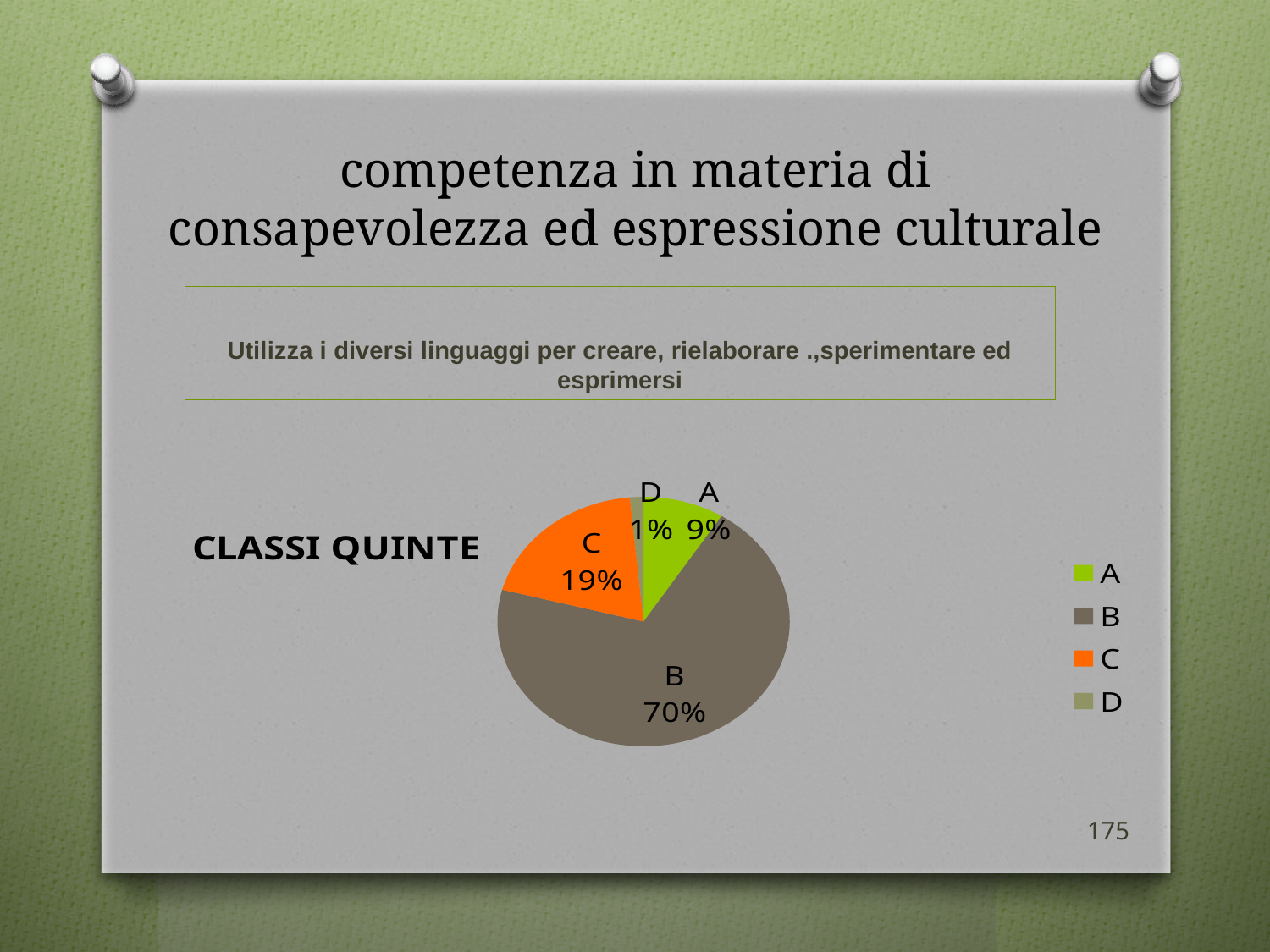
Which slice of the pie chart is the smallest? D What colour is slice C in the pie chart? orange How many entries does the legend list? 4 What percentage does slice C represent in the pie chart? 19% What kind of chart is shown on the slide? pie chart What percentage does slice B represent in the pie chart? 70% Which is larger, slice A or slice C? C Which slice of the pie chart is the largest? B What is the difference in percentage points between slice B and slice C? 51 What percentage does slice A represent in the pie chart? 9% How many slices does the pie chart have? 4 What percentage does slice D represent in the pie chart? 1%